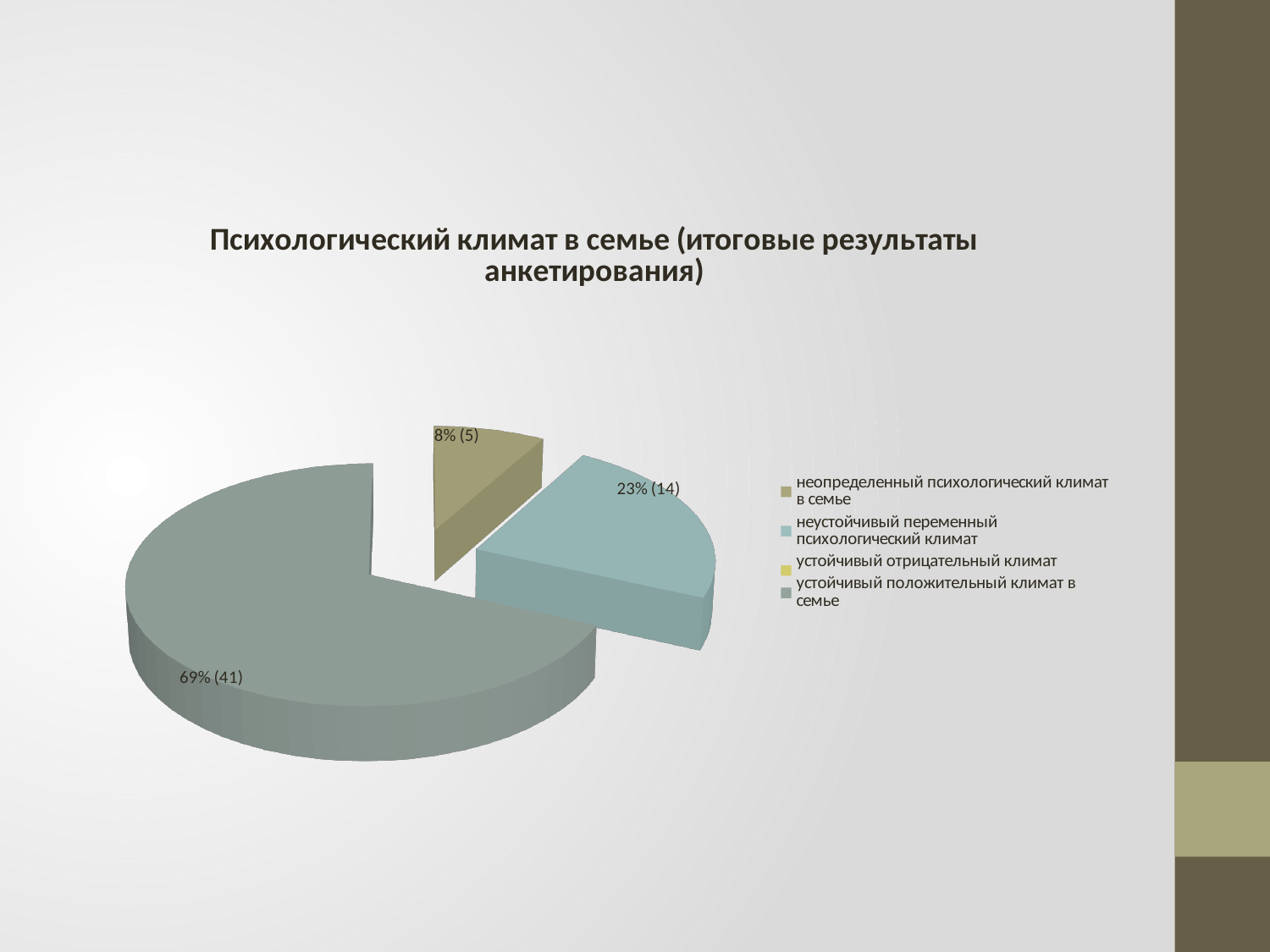
Which is larger: the slice for 'неопределенный психологический климат в семье' or the slice for 'неустойчивый переменный психологический климат'? неустойчивый переменный психологический климат What is the title of the chart? Психологический климат в семье (итоговые результаты анкетирования) What share of the pie does 'неустойчивый переменный психологический климат' take? 23% What is the data label shown for 'неопределенный психологический климат в семье'? 8% (5) How many slices with data labels are visible in the pie chart? 3 What is the data label shown for 'неустойчивый переменный психологический климат'? 23% (14) Which labelled slice is the smallest? неопределенный психологический климат в семье How many more respondents are in 'устойчивый положительный климат в семье' than in 'неустойчивый переменный психологический климат'? 27 What kind of chart is shown on the slide? pie chart How many entries does the chart legend list? 4 Which category has the largest slice of the pie? устойчивый положительный климат в семье What is the data label shown for 'устойчивый положительный климат в семье'? 69% (41)